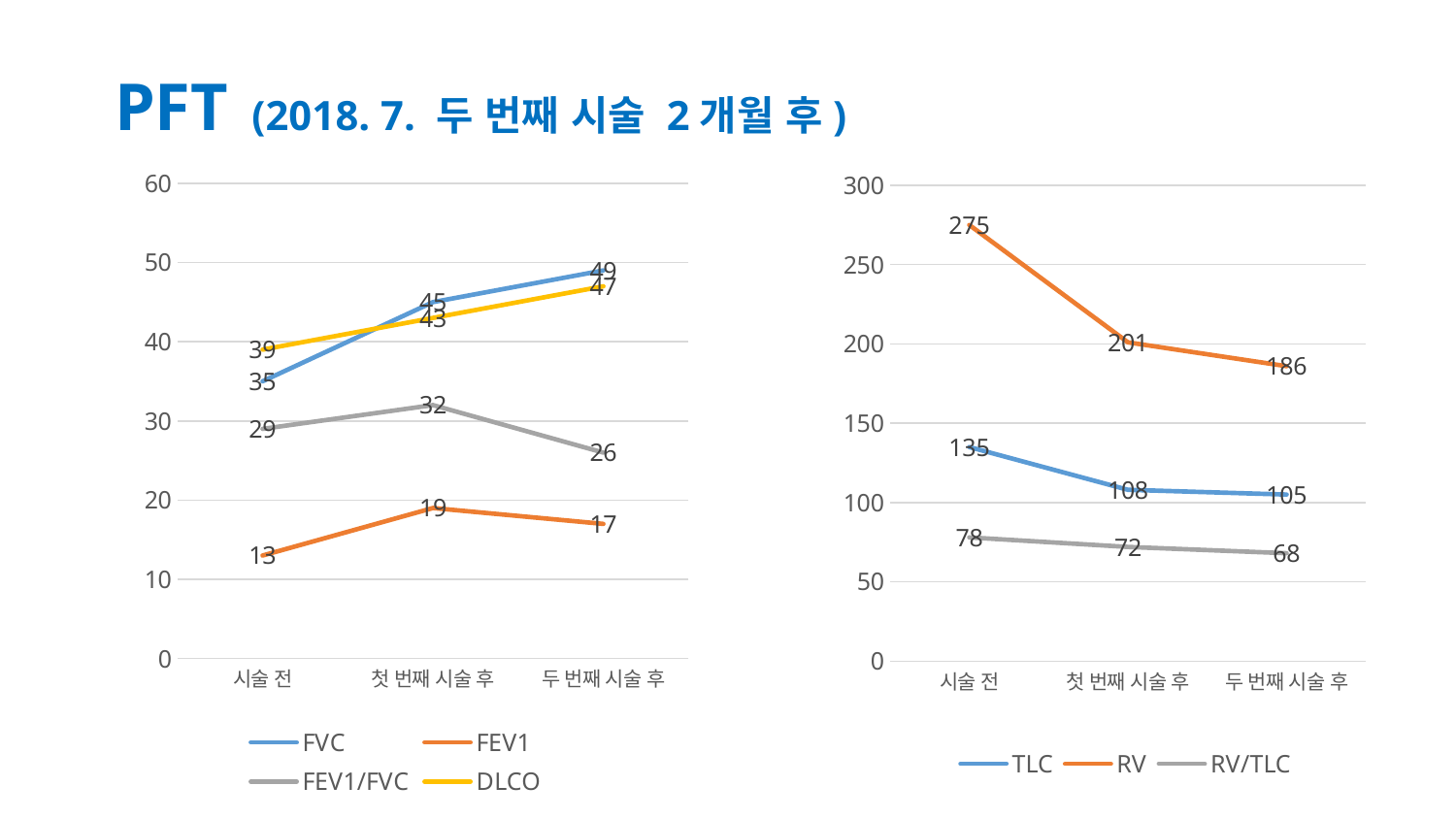
In the left chart, what is the FVC value at 두 번째 시술 후? 49 In the left chart, what is the difference between the DLCO values at 두 번째 시술 후 and 시술 전? 8 What kind of chart is the right chart? line chart In the right chart, what is the TLC value at 두 번째 시술 후? 105 In the right chart, what is the difference between the RV values at 시술 전 and 두 번째 시술 후? 89 How many series does the legend of the left chart list? 4 In the left chart, at which category is FEV1/FVC lowest? 두 번째 시술 후 In the left chart, which is larger at 첫 번째 시술 후: FVC or DLCO? FVC In the right chart, at which category is RV highest? 시술 전 In the right chart, what is the RV value at 첫 번째 시술 후? 201 In the right chart, does the RV/TLC series rise or fall across the x axis? fall In the left chart, what is the FEV1 value at 시술 전? 13